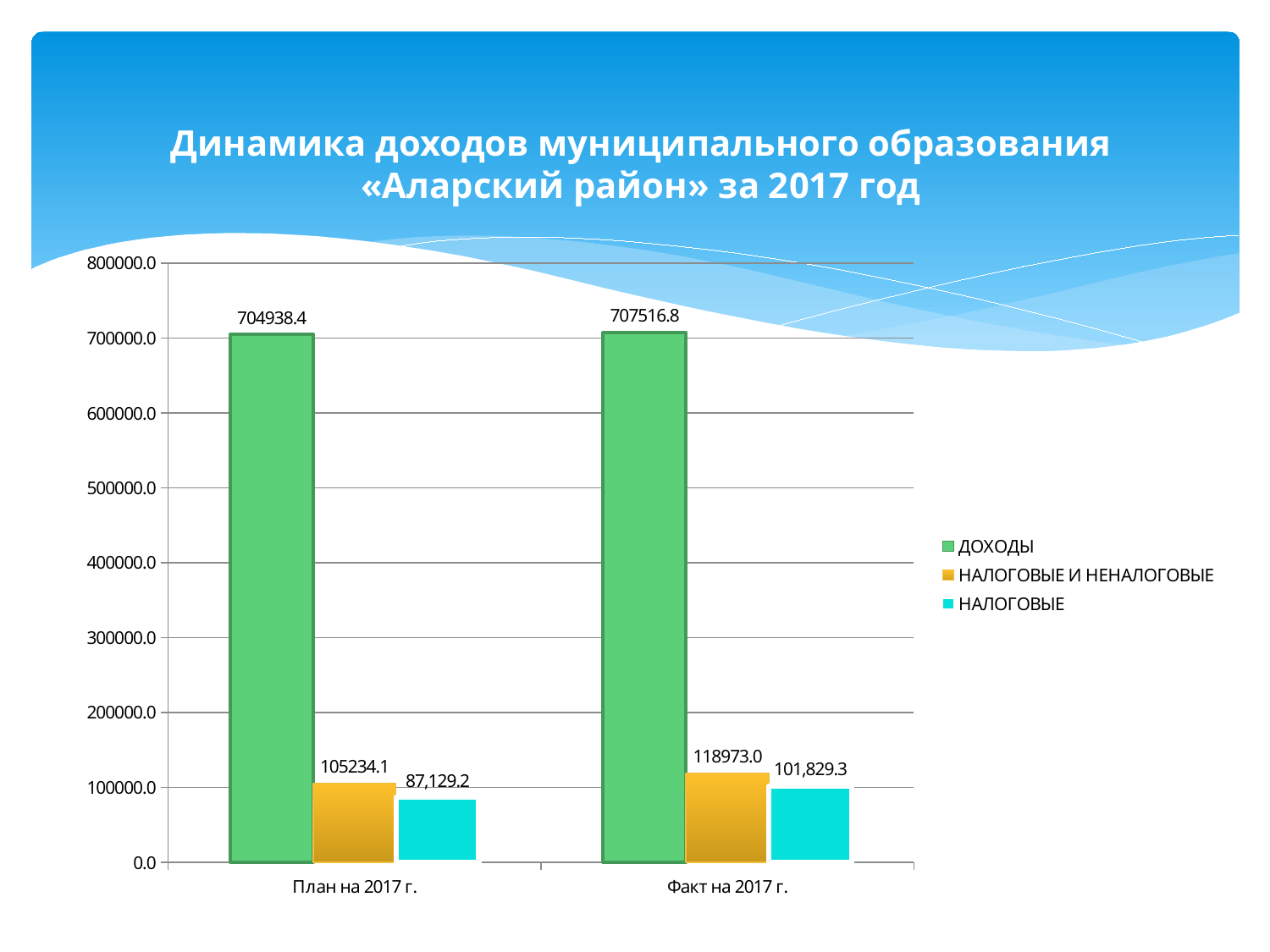
What kind of chart is shown on the slide? bar chart What is the value of НАЛОГОВЫЕ И НЕНАЛОГОВЫЕ for Факт на 2017 г.? 118973.0 What is the difference between the ДОХОДЫ values for Факт на 2017 г. and План на 2017 г.? 2578.4 What is the value of НАЛОГОВЫЕ for Факт на 2017 г.? 101,829.3 How many series does the legend list? 3 What is the value of НАЛОГОВЫЕ for План на 2017 г.? 87,129.2 What is the value of ДОХОДЫ for План на 2017 г.? 704938.4 What is the difference between the НАЛОГОВЫЕ И НЕНАЛОГОВЫЕ values for Факт на 2017 г. and План на 2017 г.? 13738.9 Which series has the lowest value for План на 2017 г.? НАЛОГОВЫЕ Is the НАЛОГОВЫЕ И НЕНАЛОГОВЫЕ value for План на 2017 г. larger or smaller than the value for Факт на 2017 г.? smaller Which series has the highest value for Факт на 2017 г.? ДОХОДЫ What is the value of ДОХОДЫ for Факт на 2017 г.? 707516.8